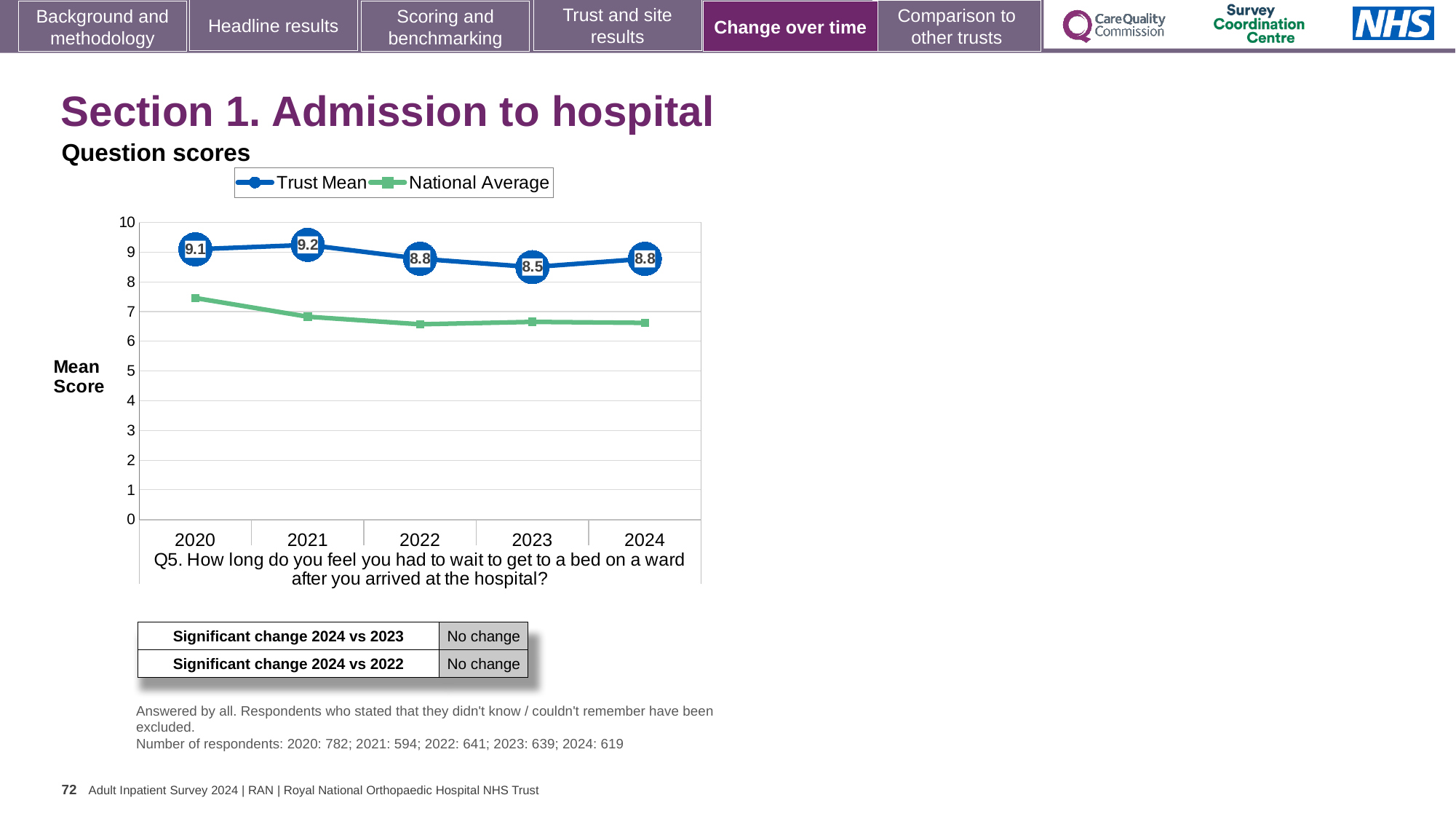
What kind of chart is shown? Line chart What is the Trust Mean score for 2020? 9.1 What is the difference between the Trust Mean in 2021 and in 2023? 0.7 How many years are shown on the x axis? 5 Is the National Average for 2022 greater or less than 7? less In which year is the Trust Mean highest? 2021 What is the Trust Mean score for 2021? 9.2 In which year is the Trust Mean lowest? 2023 What is the Trust Mean score for 2023? 8.5 Is the National Average for 2020 greater or less than 7? greater Which is larger in 2024, the Trust Mean or the National Average? Trust Mean How many series does the legend list? 2